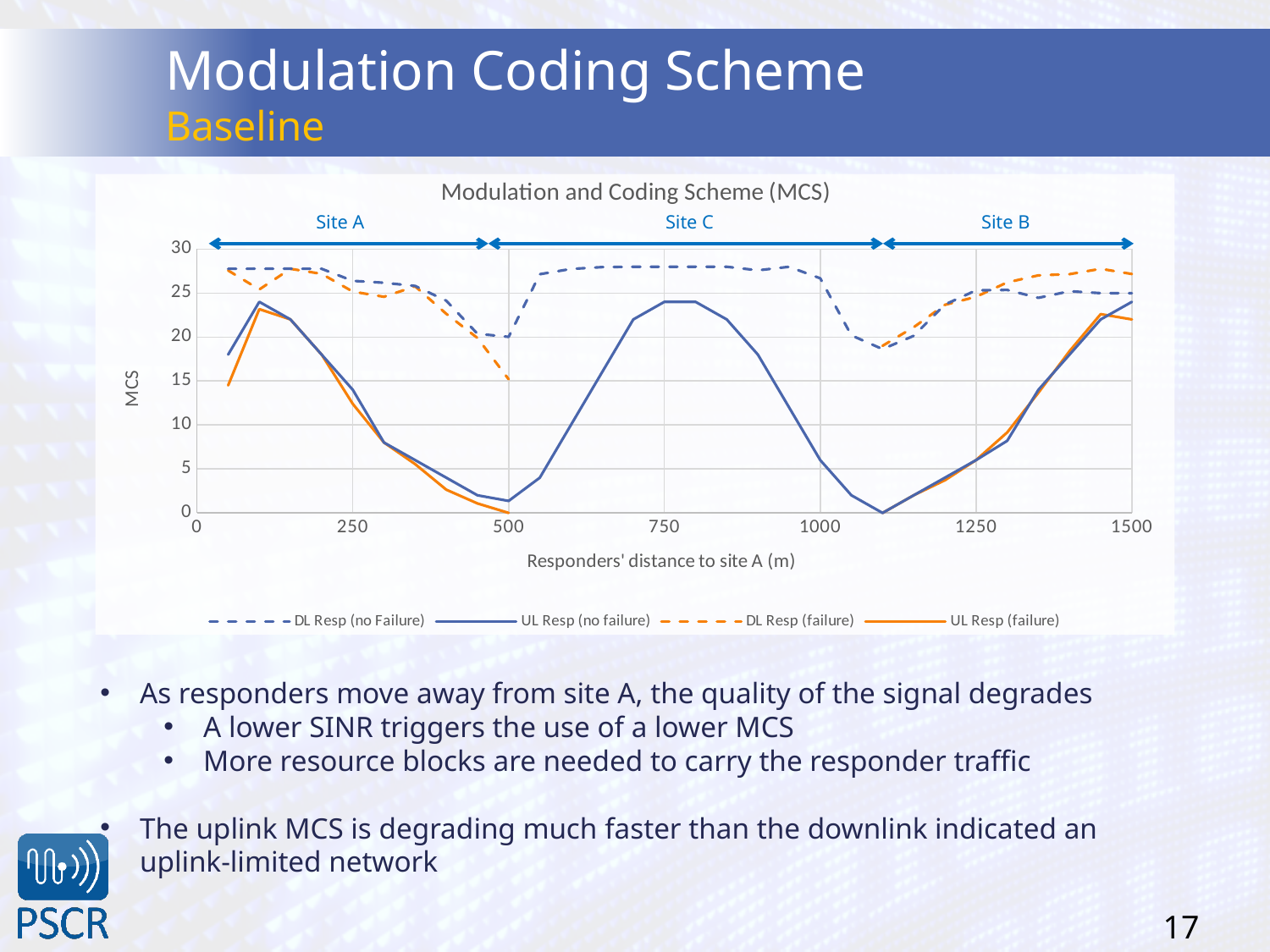
Is the value of DL Resp (no Failure) at 750 m greater or less than 25? greater Is the value of UL Resp (no failure) at 500 m greater or less than 5? less Does UL Resp (no failure) rise or fall between 250 m and 500 m? fall Is the value of UL Resp (no failure) at 750 m greater or less than 20? greater What is the label of the x axis? Responders' distance to site A (m) What kind of chart is shown on the slide? line chart What is the title of the chart? Modulation and Coding Scheme (MCS) How many series does the legend list? 4 At 750 m, which series is higher: DL Resp (no Failure) or UL Resp (no failure)? DL Resp (no Failure) Does UL Resp (no failure) rise or fall between 500 m and 750 m? rise